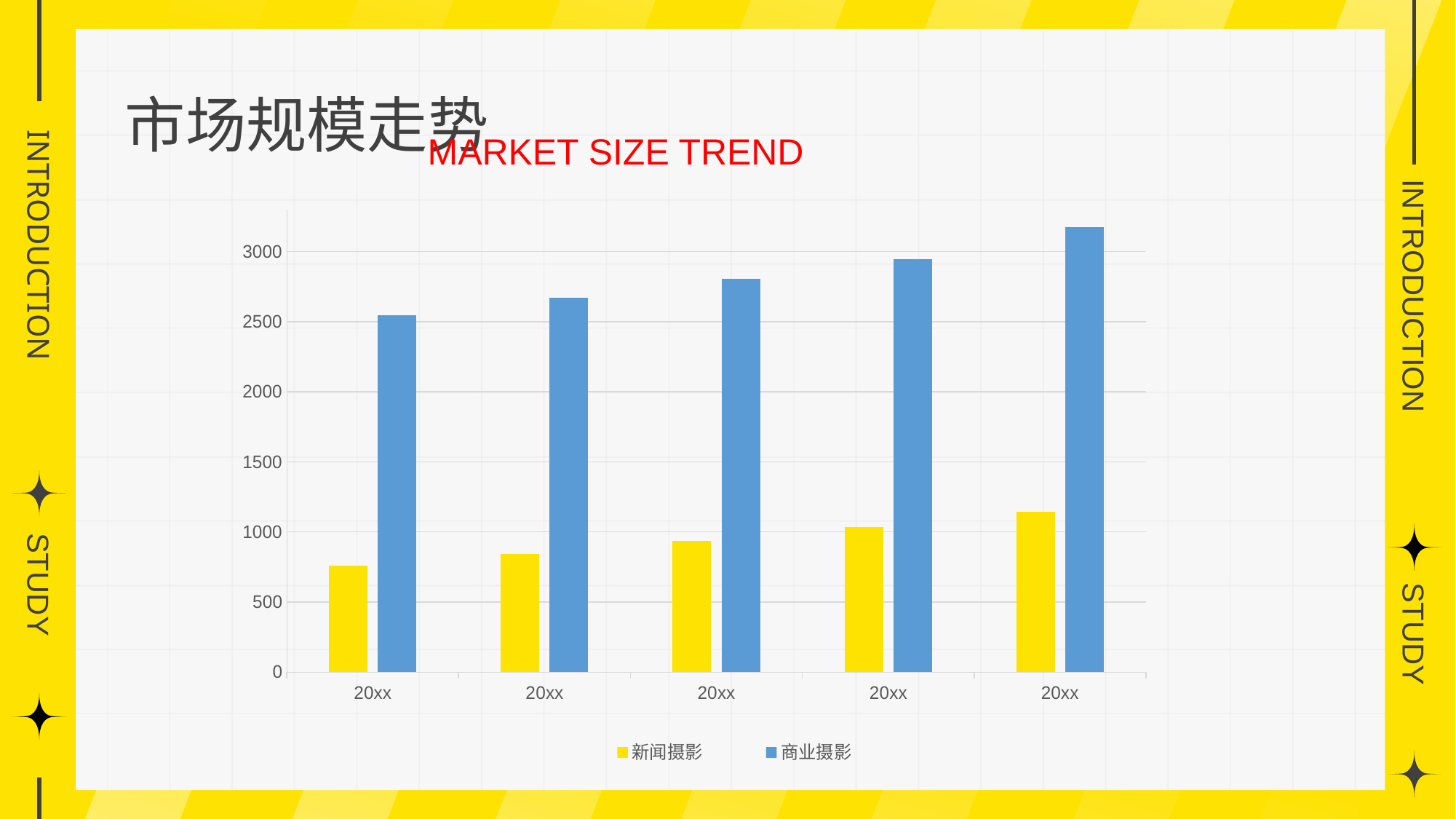
How many series does the chart legend list? 2 What is the English subtitle of the chart slide? MARKET SIZE TREND Is the value of 商业摄影 for the first (leftmost) category greater or less than 3000? less How many categories are shown along the x axis of the chart? 5 In the third category, which series has the larger value, 新闻摄影 or 商业摄影? 商业摄影 Is the value of 新闻摄影 for the first (leftmost) category greater or less than 1000? less Which category has the lowest value for 新闻摄影? the first (leftmost) category Which category has the highest value for 商业摄影? the fifth (rightmost) category Is the value of 商业摄影 for the fifth (rightmost) category greater or less than 3000? greater Which series is shown in yellow in the chart? 新闻摄影 What kind of chart is shown on the slide? bar chart